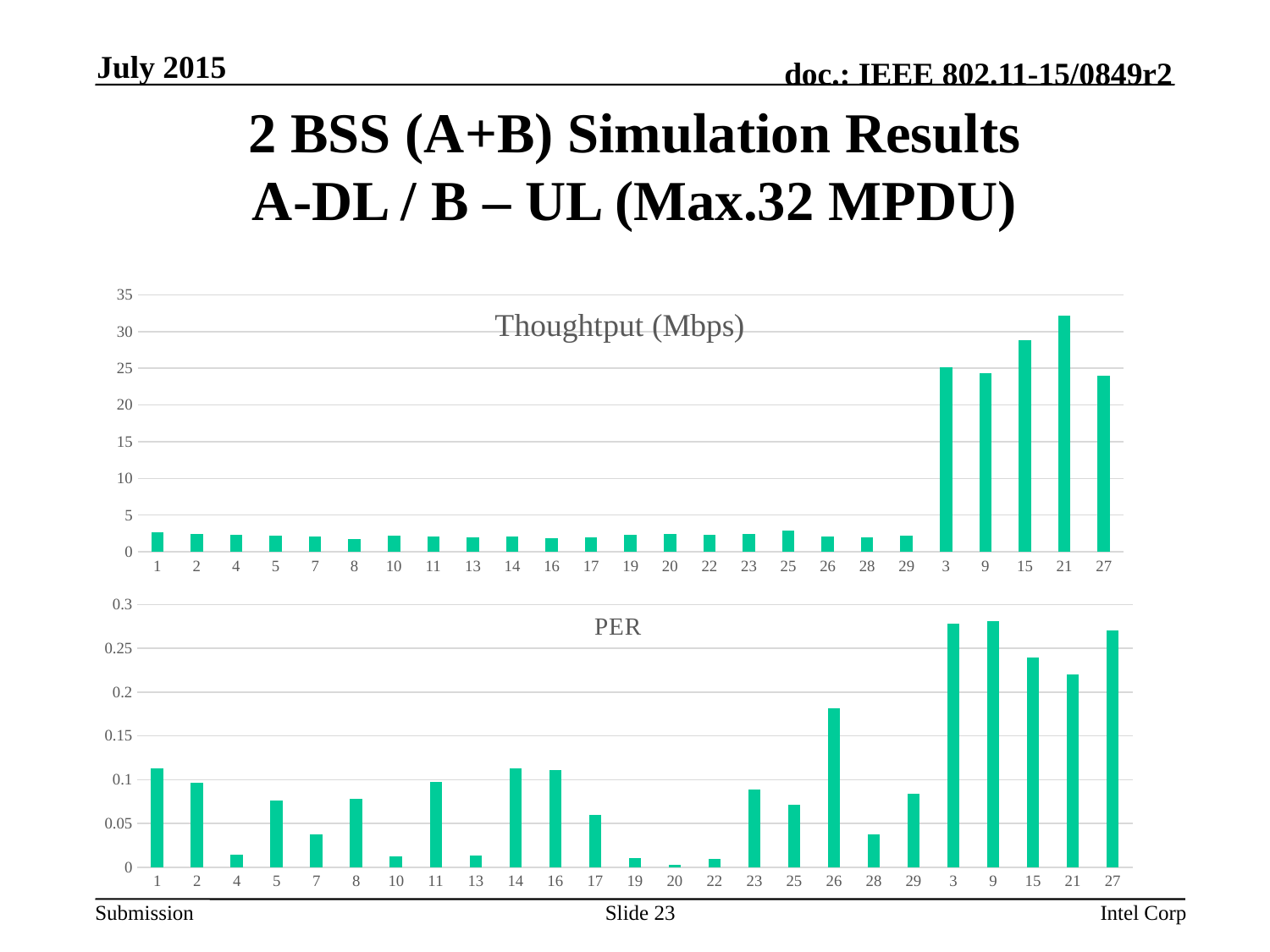
How many categories are shown on the x axis of the PER chart? 25 What kind of chart is the Thoughtput (Mbps) chart? bar chart In the PER chart, which category has the lowest value? 20 What is the title of the top chart on the slide? Thoughtput (Mbps) In the PER chart, which is larger, the value for category 26 or the value for category 23? 26 In the Thoughtput (Mbps) chart, is the value for category 21 greater or less than 30? greater In the PER chart, is the value for category 3 greater or less than 0.25? greater In the Thoughtput (Mbps) chart, is the value for category 1 greater or less than 5? less In the Thoughtput (Mbps) chart, which category has the highest value? 21 In the Thoughtput (Mbps) chart, which is larger, the value for category 21 or the value for category 27? 21